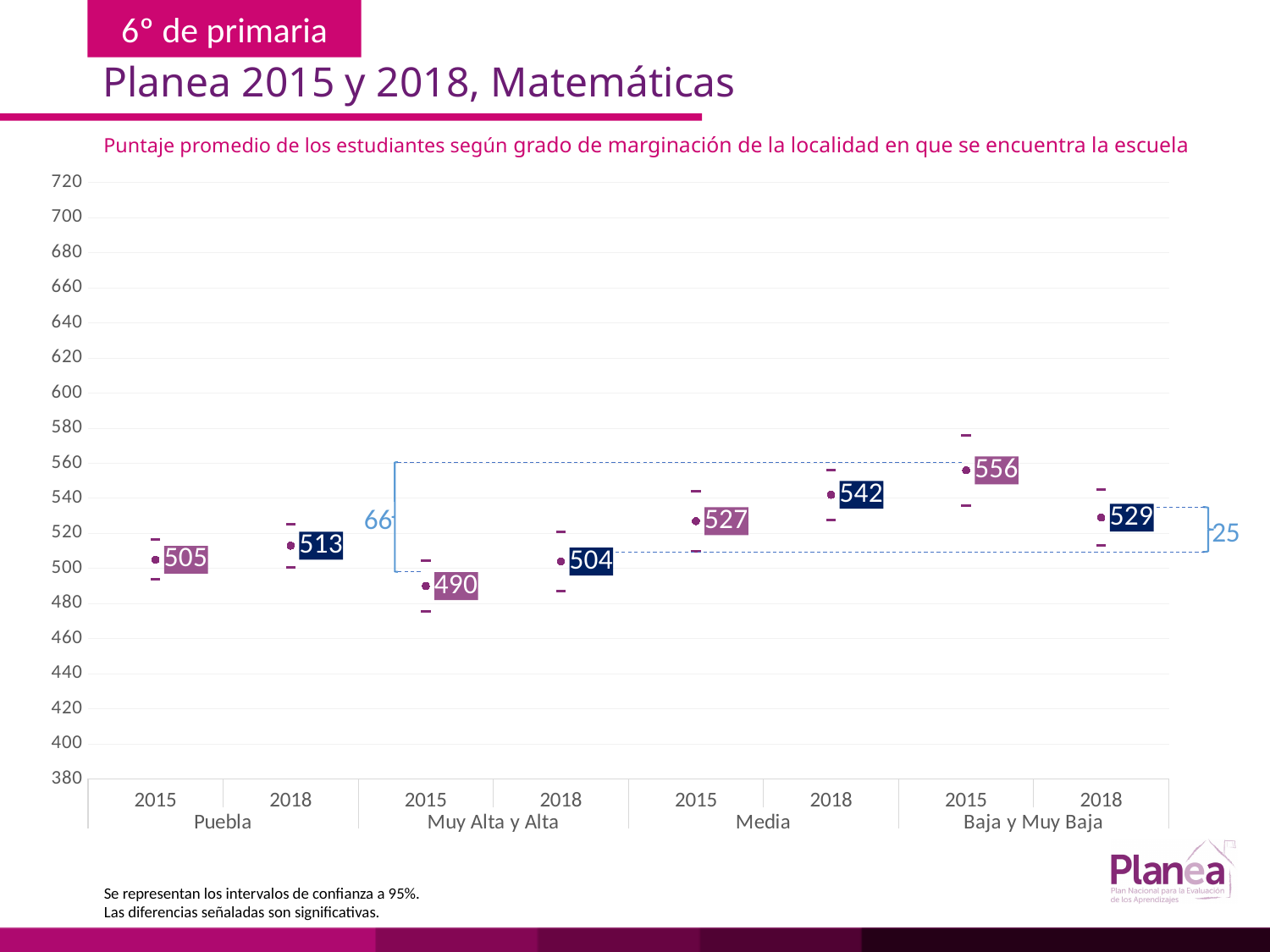
What is the average score for the Baja y Muy Baja marginación group in 2015? 556 What is the difference between the 2018 scores of the Media group and the Muy Alta y Alta group? 38 What is the average score for Puebla in 2015? 505 Which is larger, the 2018 score for Puebla or the 2018 score for the Muy Alta y Alta group? Puebla What is the lowest value shown on the vertical axis? 380 Which group and year has the highest average score on the chart? Baja y Muy Baja, 2015 Which group and year has the lowest average score on the chart? Muy Alta y Alta, 2015 What is the average score for the Muy Alta y Alta marginación group in 2015? 490 What is the difference between the 2015 scores of the Baja y Muy Baja group and the Muy Alta y Alta group? 66 What is the average score for the Media marginación group in 2018? 542 How many data points (group-year combinations) are plotted on the chart? 8 What is the average score for Puebla in 2018? 513